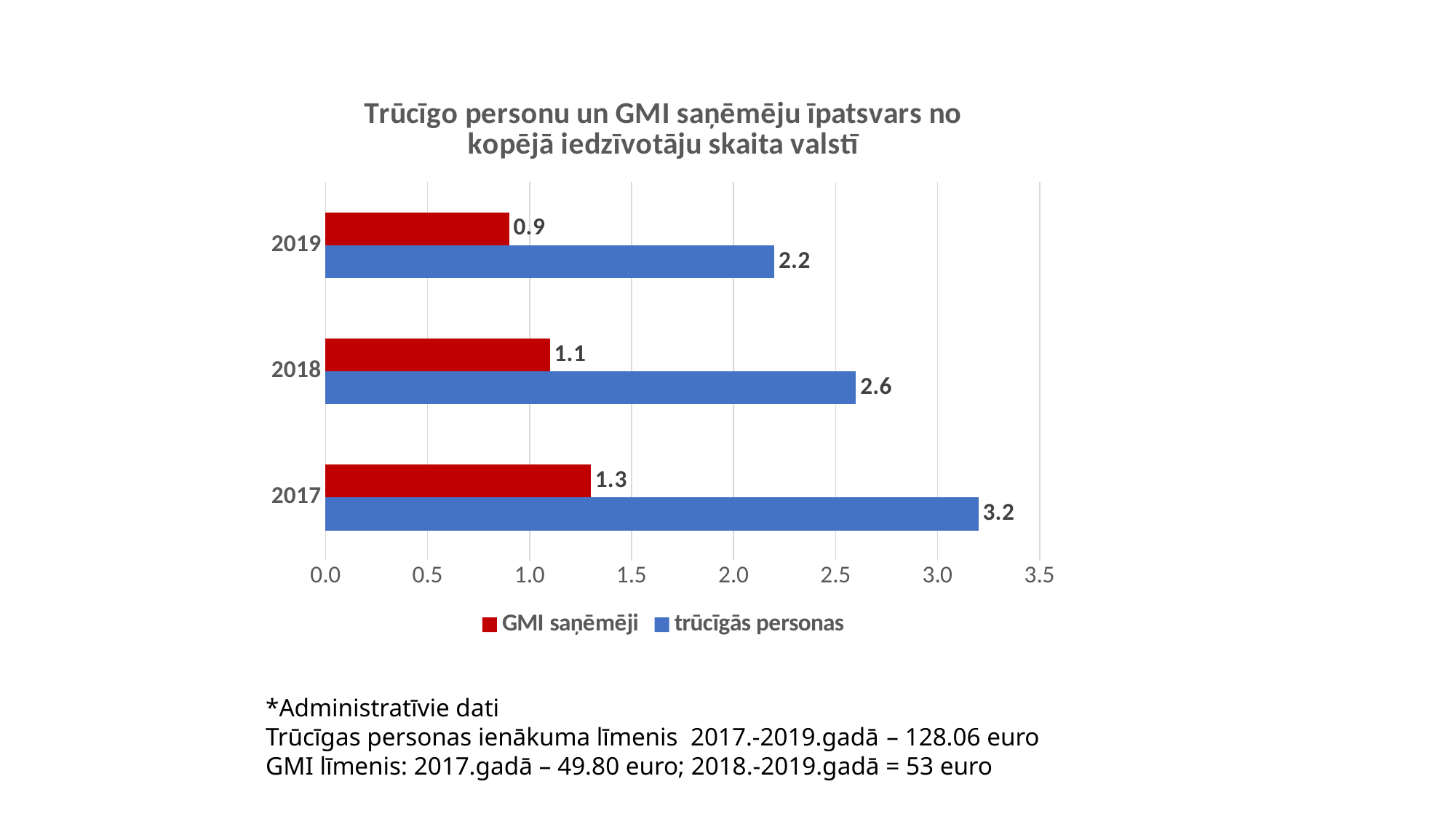
What is the value for GMI saņēmēji in 2019? 0.9 What is the value for GMI saņēmēji in 2018? 1.1 How many years are shown on the chart? 3 Do the values for trūcīgās personas rise or fall from 2017 to 2019? Fall Which is larger in 2017: GMI saņēmēji or trūcīgās personas? trūcīgās personas What is the value for trūcīgās personas in 2019? 2.2 How many series does the legend list? 2 What is the difference between trūcīgās personas and GMI saņēmēji in 2018? 1.5 Which year has the lowest value for GMI saņēmēji? 2019 What is the value for trūcīgās personas in 2017? 3.2 What kind of chart is shown on the slide? Bar chart Which year has the highest value for trūcīgās personas? 2017